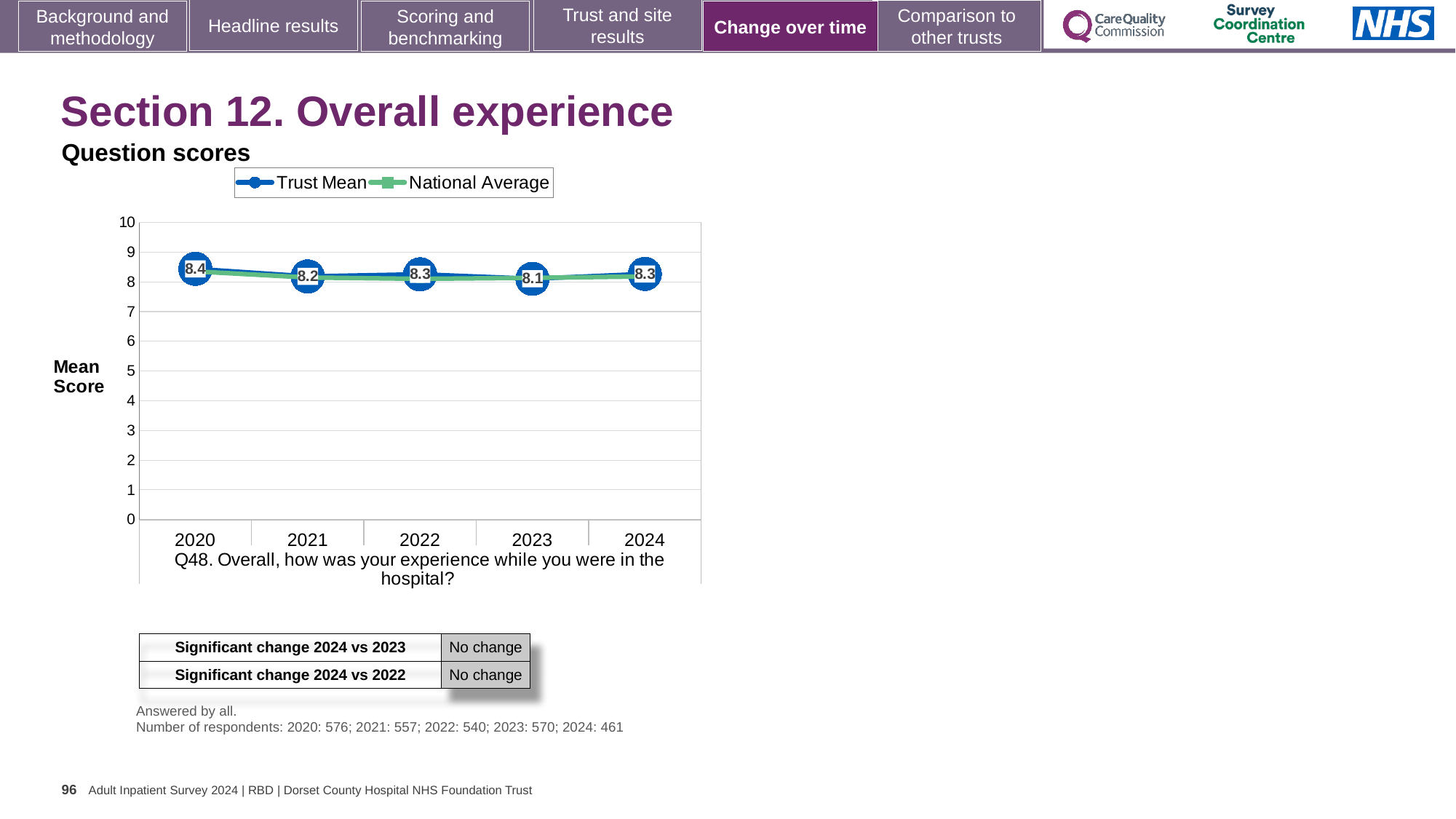
What is the Trust Mean score for 2023? 8.1 How many series does the legend list? 2 How many years are plotted on the x axis? 5 Does the Trust Mean score rise or fall from 2023 to 2024? Rise Is the National Average value for 2021 greater or less than 5? greater In which year is the Trust Mean score lowest? 2023 Which year has the larger Trust Mean score, 2022 or 2023? 2022 What kind of chart is shown on the slide? Line chart What is the difference between the Trust Mean score in 2020 and in 2023? 0.3 In which year is the Trust Mean score highest? 2020 What is the Trust Mean score for 2024? 8.3 What is the Trust Mean score for 2020? 8.4